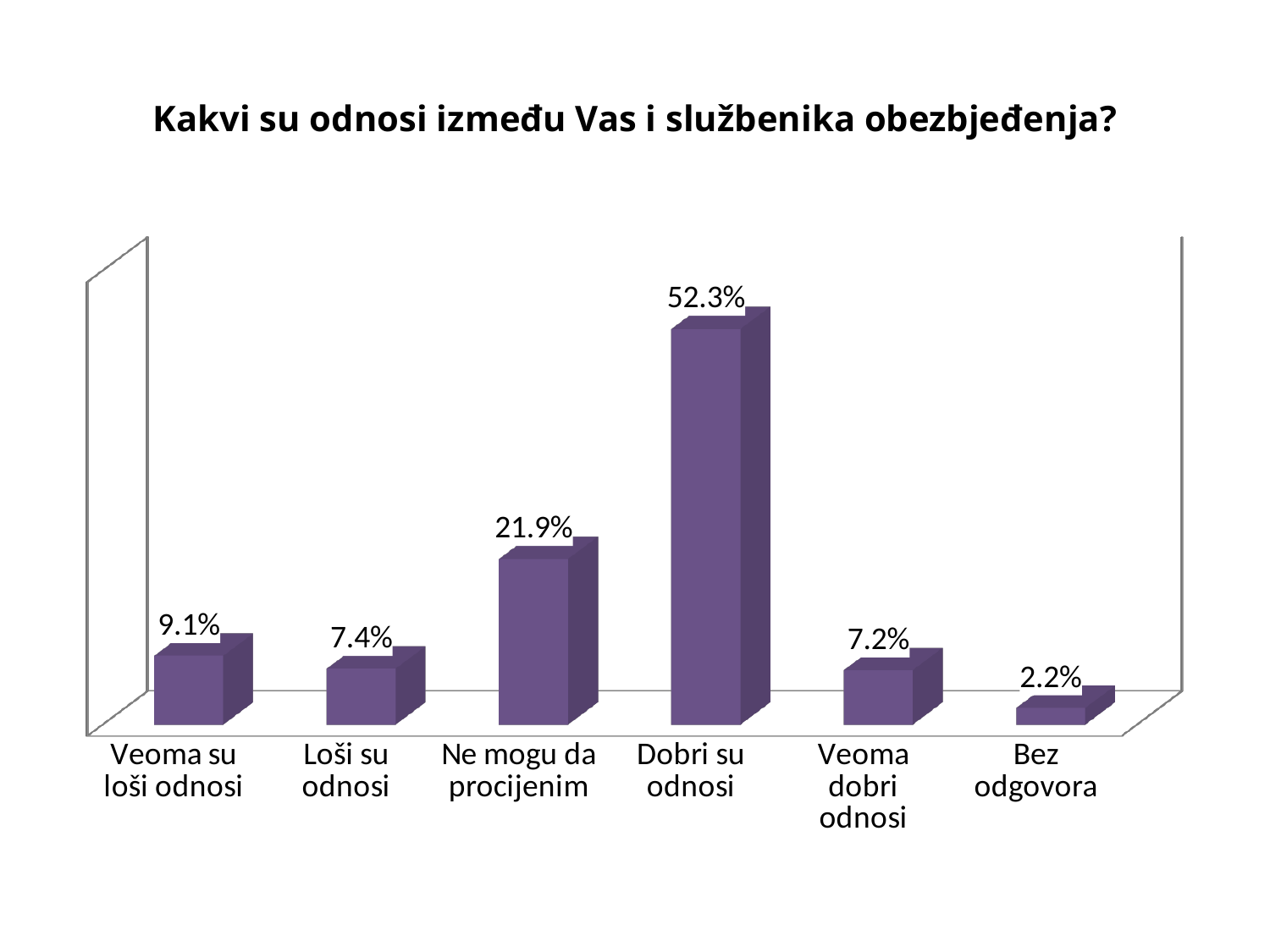
Which category has the lowest value? Bez odgovora How many categories are shown in the chart? 6 What is the difference between the values for "Dobri su odnosi" and "Ne mogu da procijenim"? 30.4% Which is larger, the value for "Loši su odnosi" or the value for "Veoma dobri odnosi"? Loši su odnosi What is the value for "Dobri su odnosi"? 52.3% What is the value for "Veoma su loši odnosi"? 9.1% What kind of chart is shown on the slide? Bar chart Which category has the highest value? Dobri su odnosi What is the value for "Bez odgovora"? 2.2% What is the title of the chart? Kakvi su odnosi između Vas i službenika obezbjeđenja? What is the value for "Ne mogu da procijenim"? 21.9% What is the difference between the values for "Veoma su loši odnosi" and "Loši su odnosi"? 1.7%